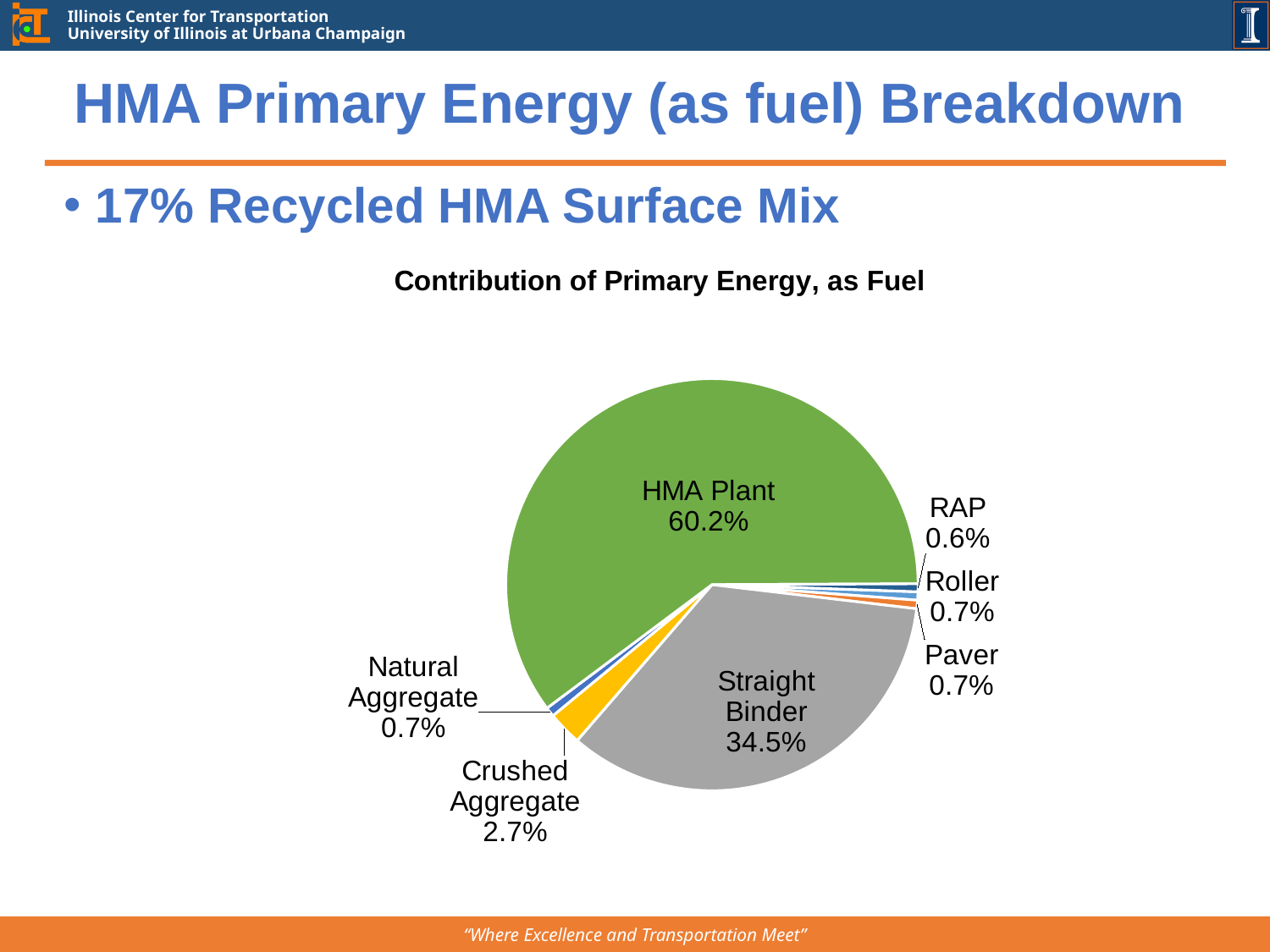
What is the value shown for RAP? 0.6% What type of chart is shown on the slide? Pie chart Which is larger, the share for Crushed Aggregate or the share for Paver? Crushed Aggregate What is the value shown for Natural Aggregate? 0.7% What is the difference in percentage points between HMA Plant and Straight Binder? 25.7 percentage points What is the title of the chart? Contribution of Primary Energy, as Fuel Which category has the largest share of the pie? HMA Plant How many slices does the pie chart have? 7 What percentage of primary energy is contributed by the HMA Plant? 60.2% Which category has the smallest share of the pie? RAP What is the value shown for Straight Binder? 34.5% What is the value shown for Crushed Aggregate? 2.7%